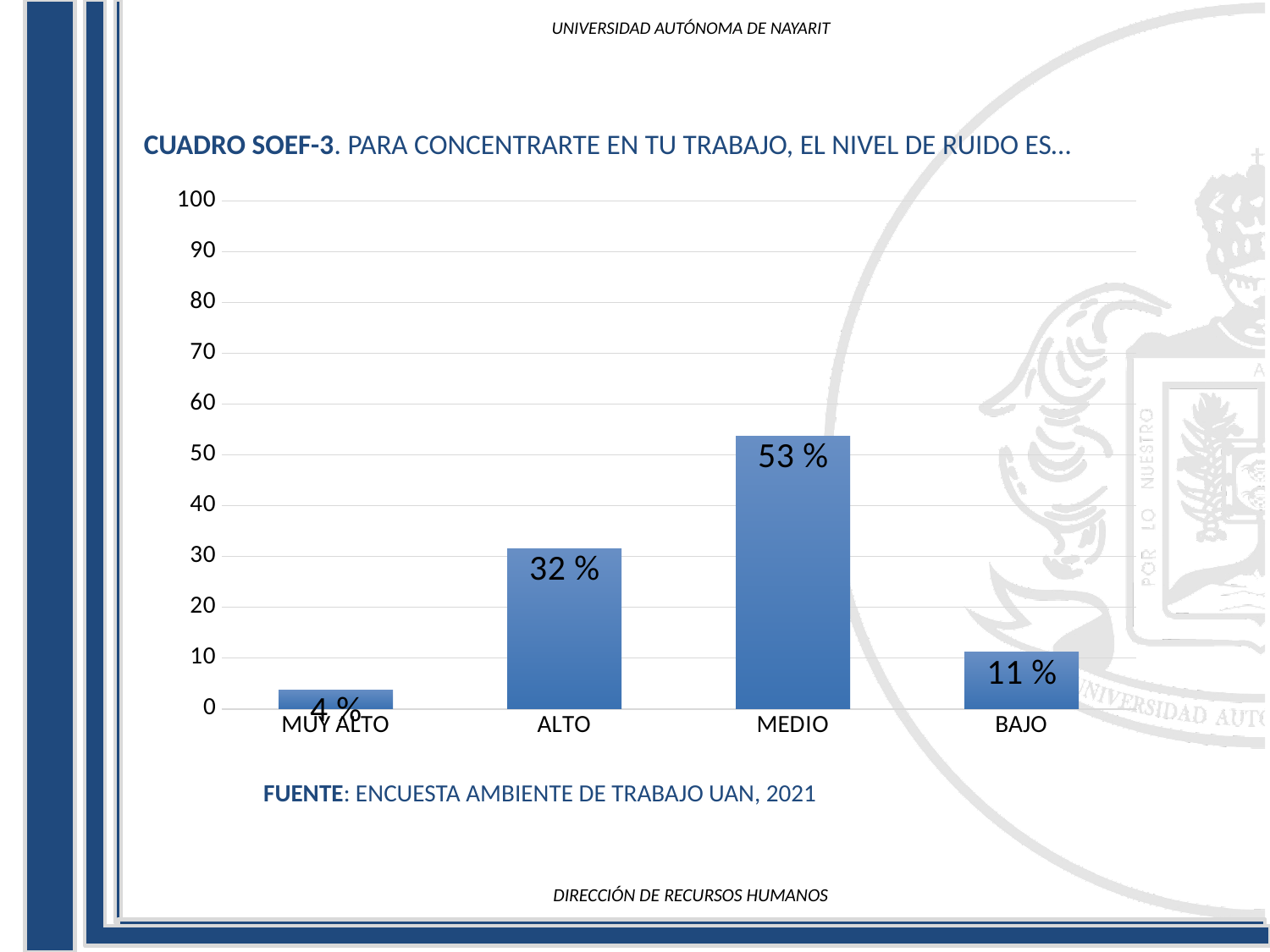
What is the difference between the values for MEDIO and ALTO? 21 % Which category has the highest value? MEDIO Is the value for MEDIO greater or less than 50? greater What kind of chart is shown on the slide? bar chart What is the difference between the values for BAJO and MUY ALTO? 7 % What is the value for ALTO? 32 % How many categories are shown on the x axis? 4 What is the value for BAJO? 11 % Which is larger, the value for ALTO or the value for BAJO? ALTO What is the value for MUY ALTO? 4 % Which category has the lowest value? MUY ALTO What is the value for MEDIO? 53 %